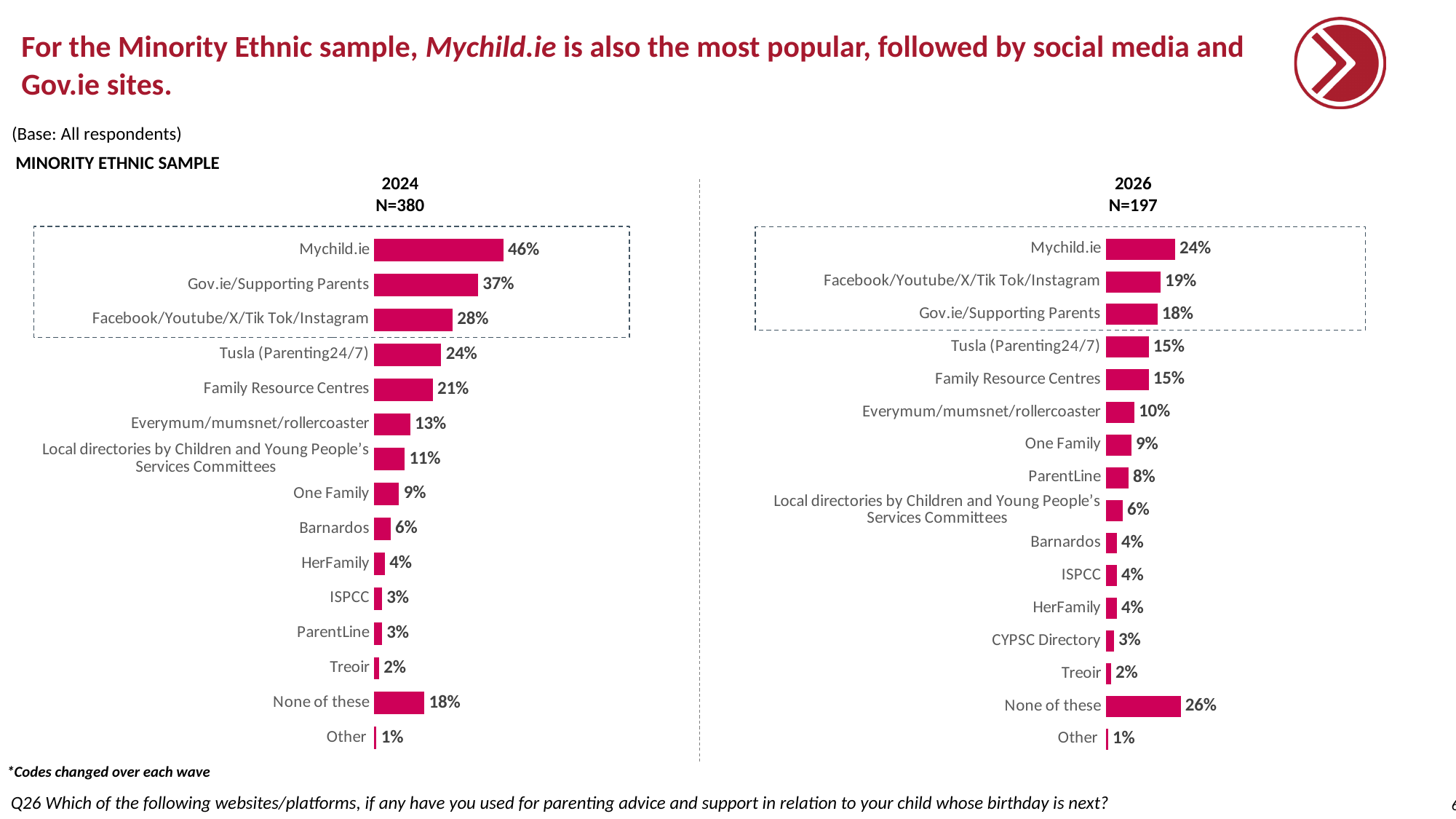
In the 2026 chart, what is the difference between the percentages for Mychild.ie and Gov.ie/Supporting Parents? 6% How many categories are shown in the 2026 chart? 16 In the 2024 chart, which is larger: Family Resource Centres or Everymum/mumsnet/rollercoaster? Family Resource Centres In the 2026 chart, which category has the highest percentage? None of these In the 2026 chart, what percentage is shown for Facebook/Youtube/X/Tik Tok/Instagram? 19% What type of chart is used for the 2024 data? Bar chart In the 2026 chart, what percentage is shown for None of these? 26% In the 2024 chart, what percentage is shown for Mychild.ie? 46% In the 2024 chart, which category has the lowest percentage? Other In the 2024 chart, what is the difference between the percentages for Mychild.ie and Gov.ie/Supporting Parents? 9% What is the sample size (N) shown for the 2026 chart? N=197 In the 2024 chart, what percentage is shown for Tusla (Parenting24/7)? 24%